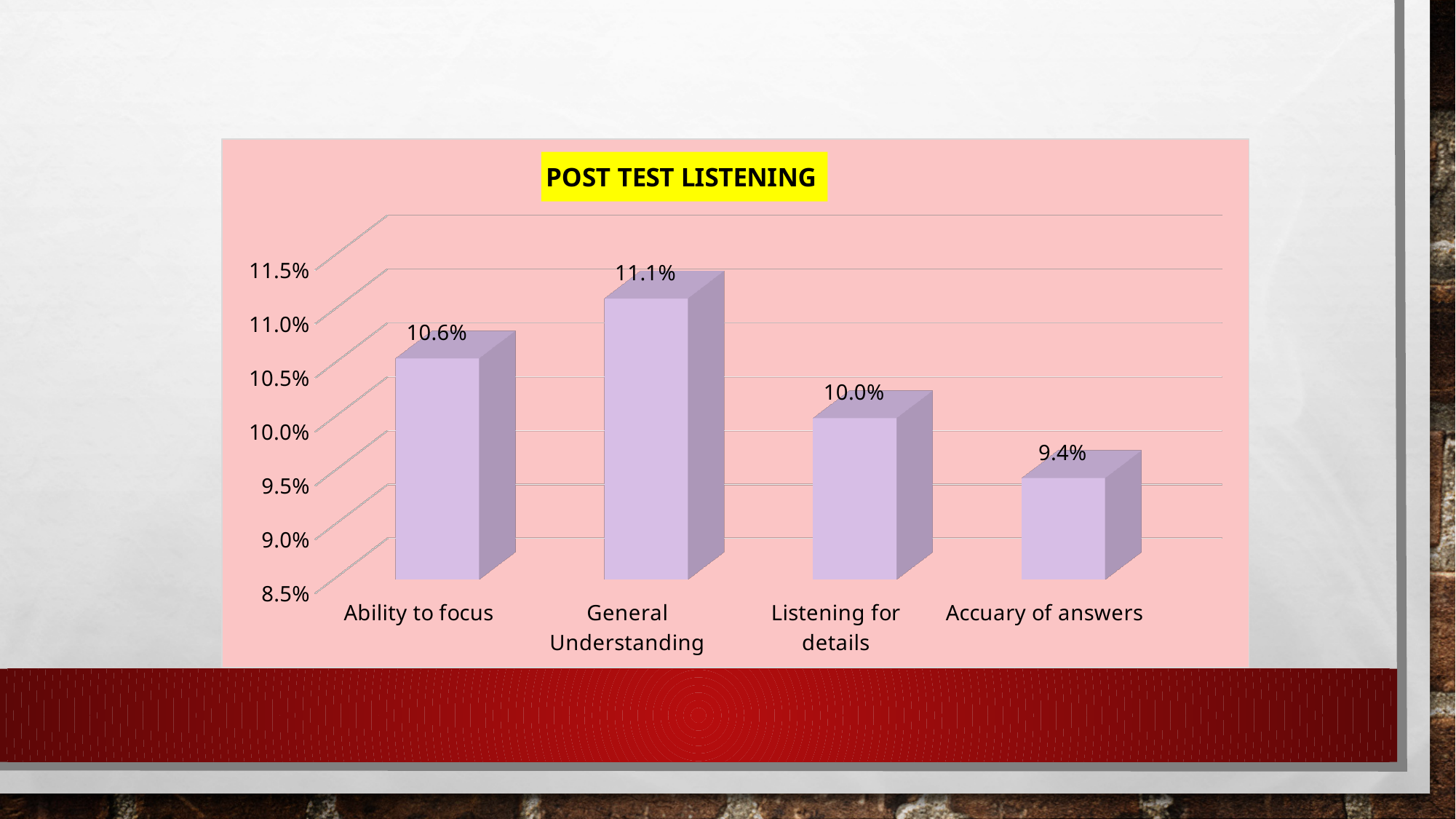
What is the difference between the values for General Understanding and Accuary of answers? 1.7% Which is larger, the value for Ability to focus or the value for Listening for details? Ability to focus What is the value for General Understanding? 11.1% What is the value for Accuary of answers? 9.4% What is the value for Listening for details? 10.0% Which category has the lowest value? Accuary of answers What is the title of the chart? POST TEST LISTENING What kind of chart is shown on the slide? Bar chart Which category has the highest value? General Understanding What is the difference between the values for Ability to focus and Listening for details? 0.6% What is the value for Ability to focus? 10.6% How many categories are shown in the chart? 4